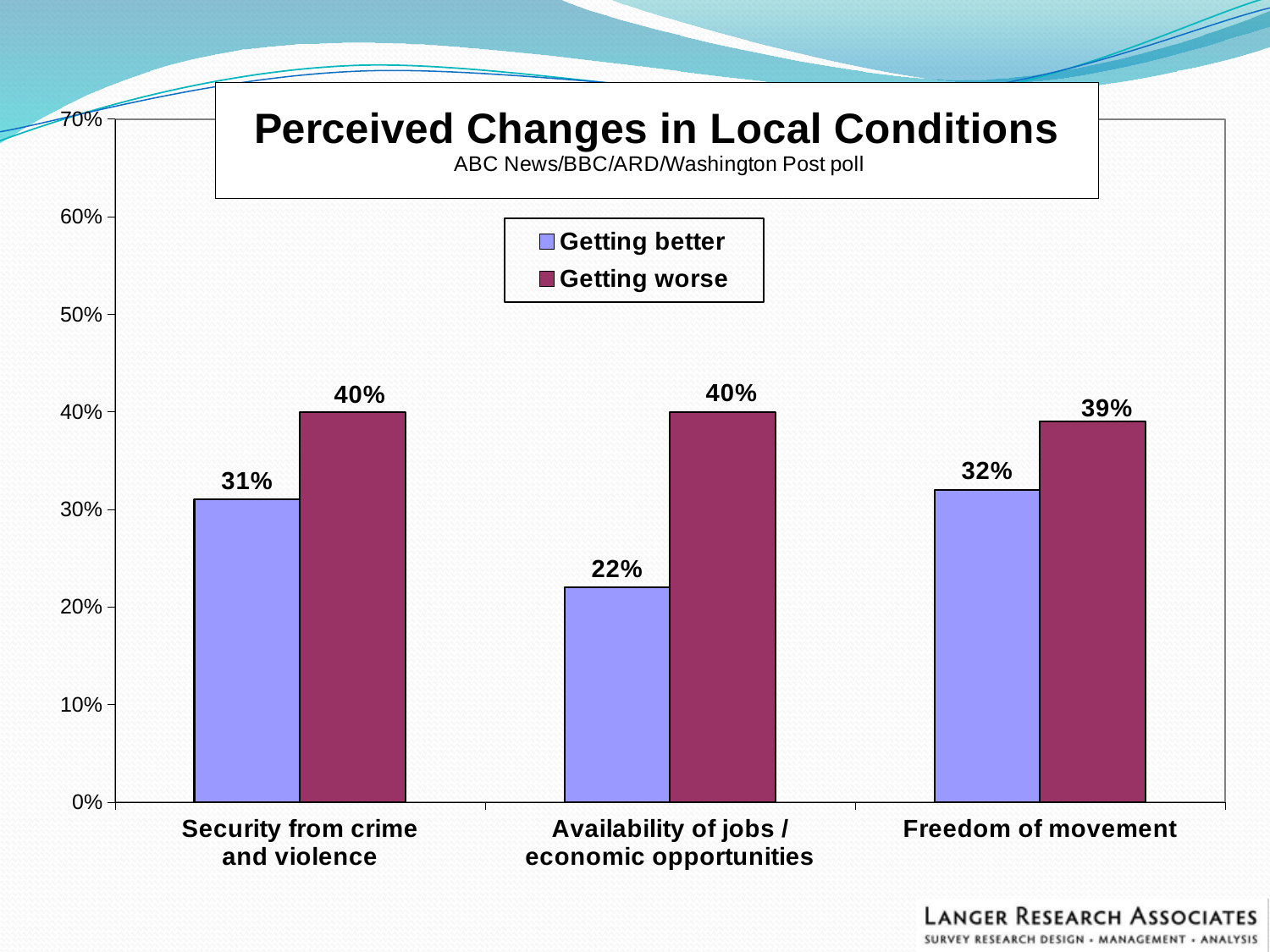
What percentage said security from crime and violence is getting better? 31% What is the 'Getting worse' value for freedom of movement? 39% Which category has the highest 'Getting better' value? Freedom of movement What percentage said availability of jobs / economic opportunities is getting worse? 40% How many categories are shown on the x axis? 3 What is the title of the chart? Perceived Changes in Local Conditions What is the difference between 'Getting worse' and 'Getting better' for availability of jobs / economic opportunities? 18% How many series does the legend list? 2 Which category has the lowest 'Getting better' value? Availability of jobs / economic opportunities Is the 'Getting better' value for security from crime and violence greater or less than 40%? less For freedom of movement, which is larger: 'Getting better' or 'Getting worse'? Getting worse What kind of chart is shown on the slide? Bar chart